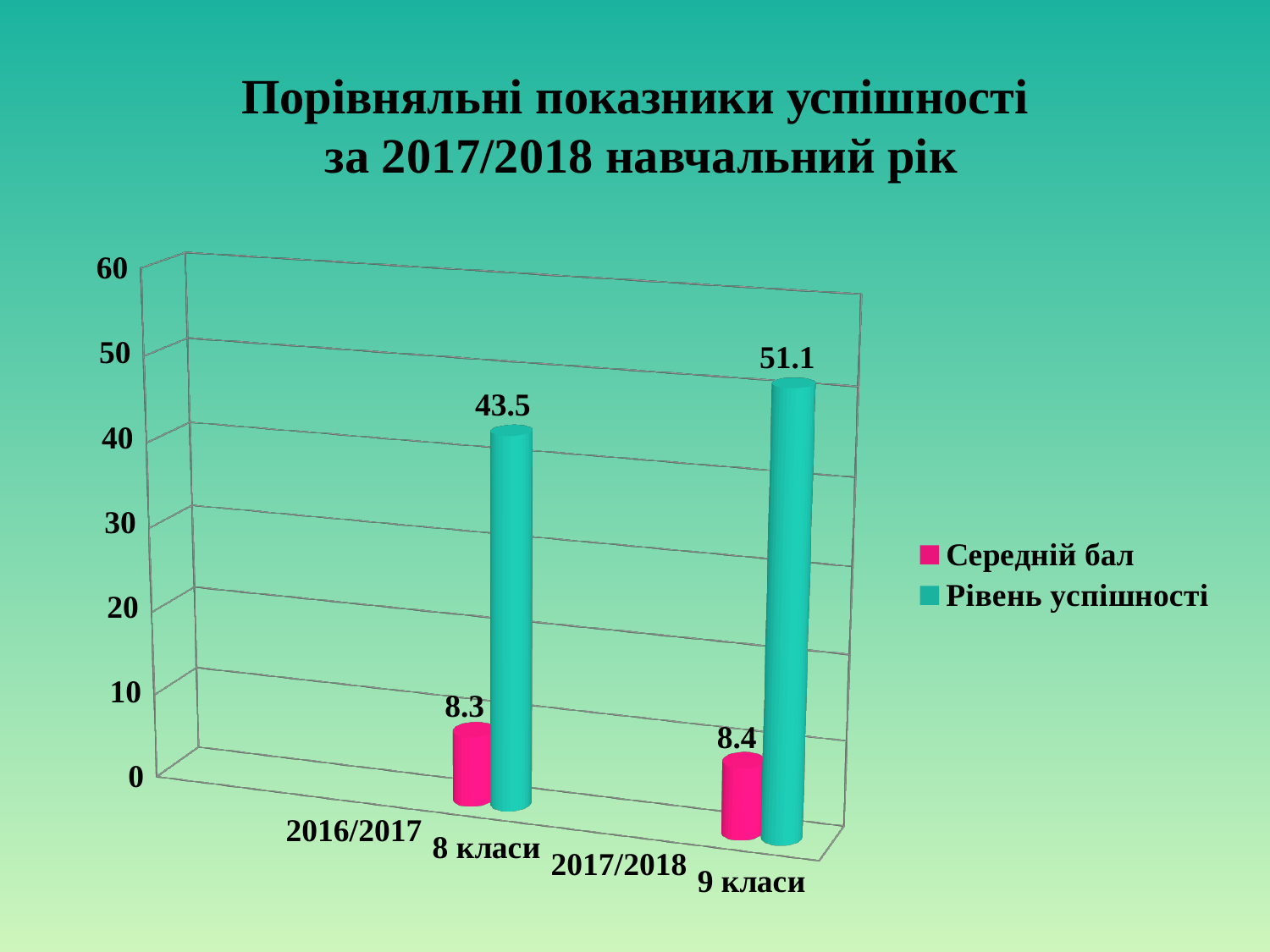
How many series does the legend list? 2 Which series is shown in pink in the legend? Середній бал What is the value of Середній бал for 2017/2018 9 класи? 8.4 How many categories are shown on the x axis? 2 What is the difference between the Рівень успішності values for 2017/2018 9 класи and 2016/2017 8 класи? 7.6 Which category has the higher Рівень успішності value? 2017/2018 9 класи What kind of chart is shown on the slide? Bar chart Is the Середній бал value for 2017/2018 9 класи greater or less than 10? less What is the value of Рівень успішності for 2017/2018 9 класи? 51.1 What is the value of Середній бал for 2016/2017 8 класи? 8.3 Is the Рівень успішності value for 2016/2017 8 класи greater or less than 40? greater What is the value of Рівень успішності for 2016/2017 8 класи? 43.5